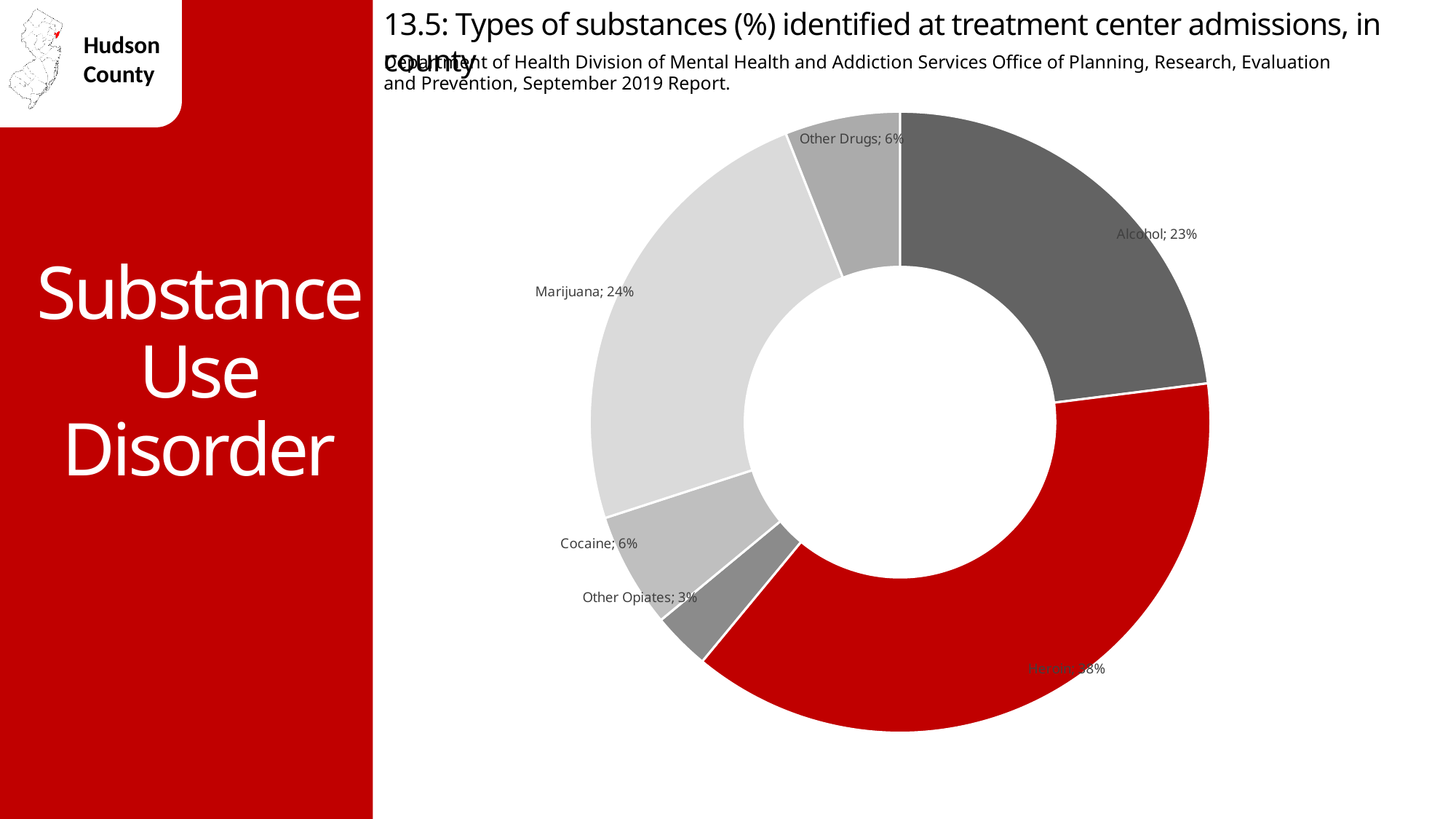
What percentage is shown for Cocaine? 6% What is the difference in percentage points between Heroin and Alcohol? 15 What percentage of treatment center admissions is attributed to Alcohol? 23% What percentage is shown for Other Opiates? 3% Which is larger, the share for Marijuana or the share for Cocaine? Marijuana How many substance categories are shown in the chart? 6 Which substance's slice is coloured red in the chart? Heroin Which substance has the smallest share of treatment center admissions? Other Opiates What kind of chart is used on this slide? Doughnut (pie) chart What percentage is shown for Marijuana? 24% Which substance has the largest share of treatment center admissions? Heroin What percentage is shown for Heroin? 38%